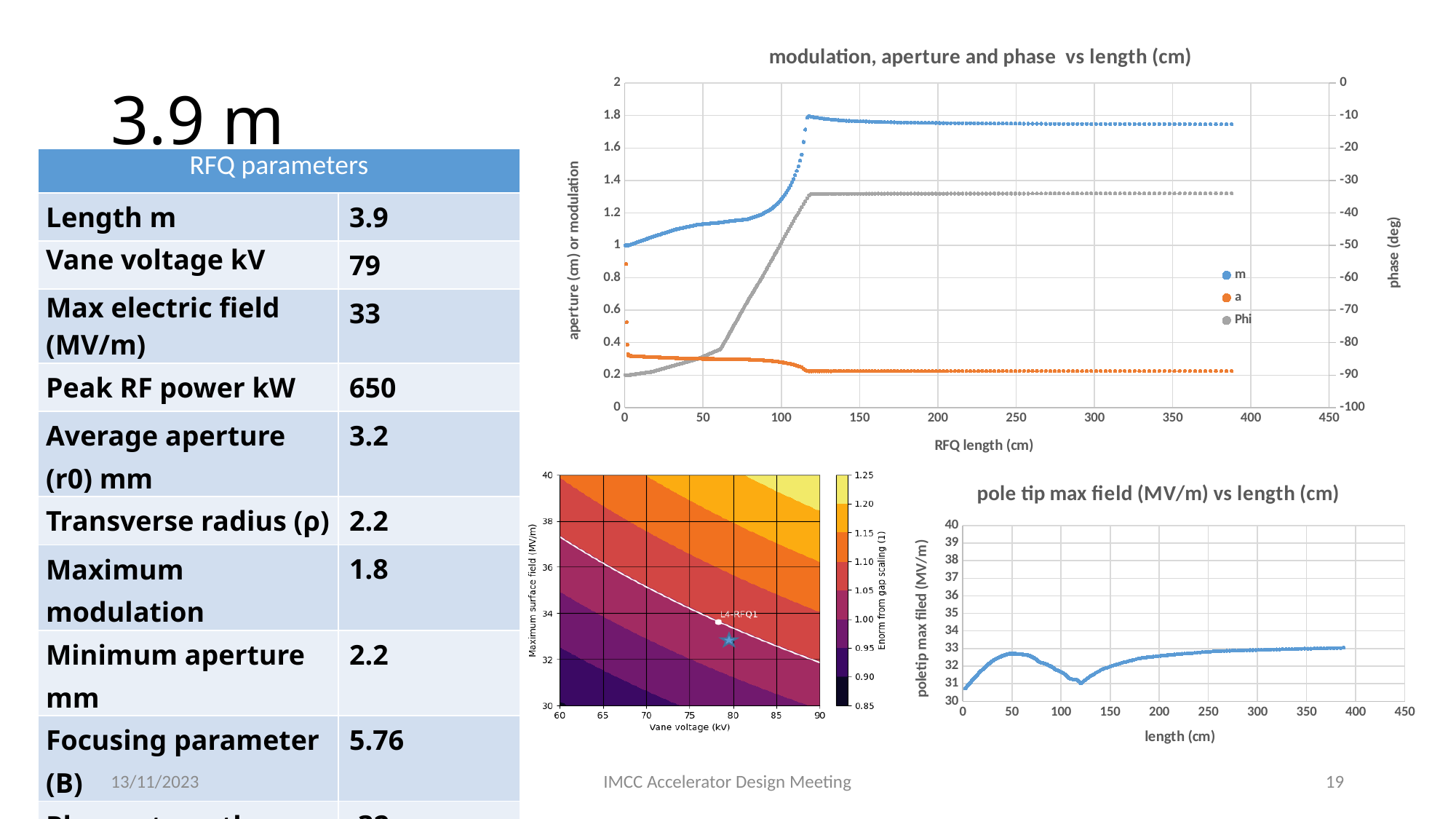
In the chart titled 'pole tip max field (MV/m) vs length (cm)', does the value rise or fall as length increases from 150 cm to 350 cm? rise What kind of chart is the chart titled 'pole tip max field (MV/m) vs length (cm)'? scatter chart In the chart titled 'modulation, aperture and phase vs length (cm)', what are the names of the series in the legend? m, a, Phi In the bottom-middle contour plot, what is the label of the x axis? Vane voltage (kV) In the chart titled 'pole tip max field (MV/m) vs length (cm)', is the value at length 300 cm greater or less than 32? greater In the chart titled 'pole tip max field (MV/m) vs length (cm)', is the value at length 0 cm greater or less than 31? less In the chart titled 'modulation, aperture and phase vs length (cm)', is the value of series m at RFQ length 300 cm greater or less than 1.6? greater In the chart titled 'modulation, aperture and phase vs length (cm)', at RFQ length 300 cm, which series has the larger value on the left axis, m or a? m In the chart titled 'modulation, aperture and phase vs length (cm)', does series a rise or fall as RFQ length increases from 0 to 150 cm? fall In the chart titled 'modulation, aperture and phase vs length (cm)', how many series does the legend list? 3